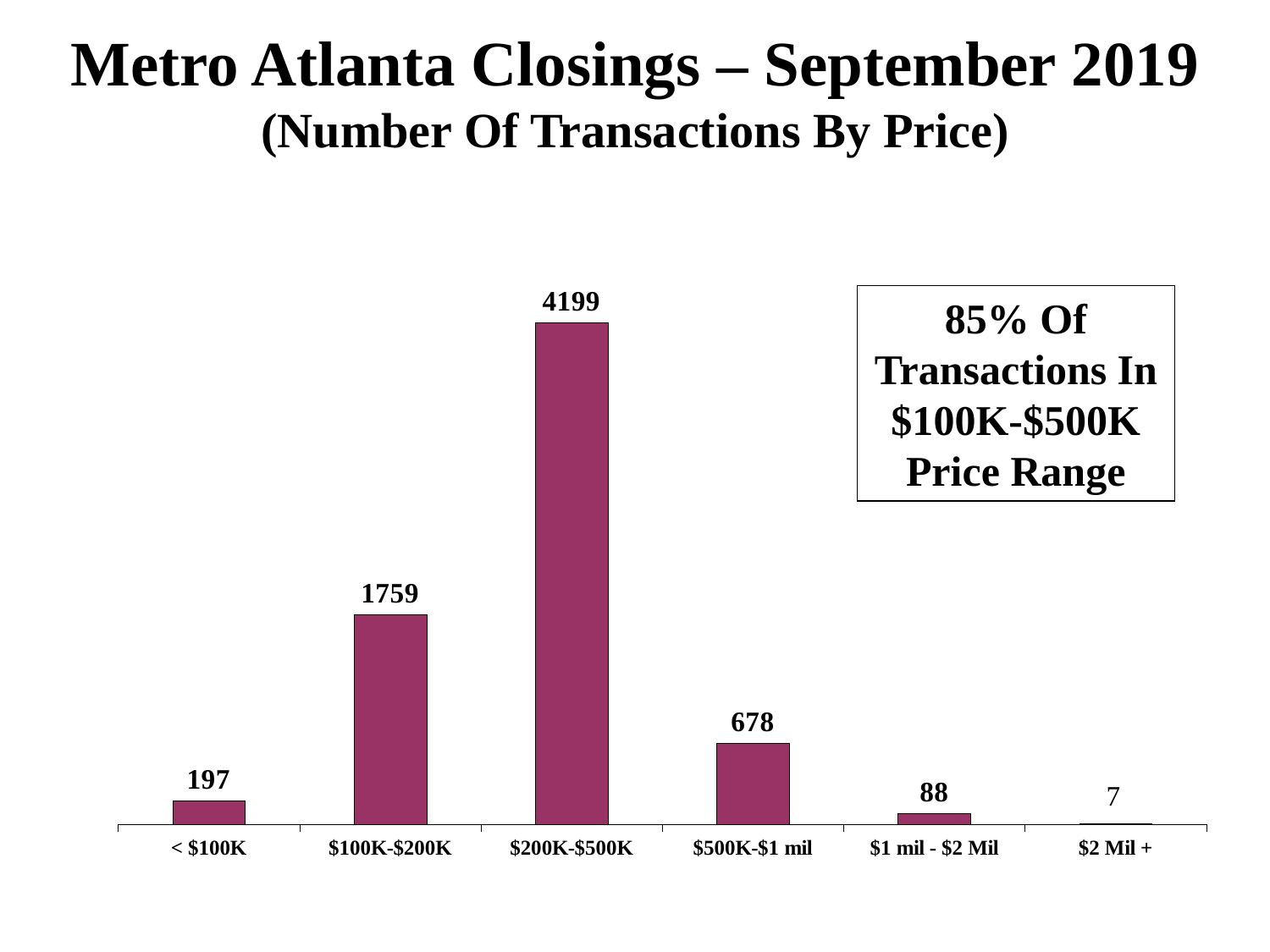
How many transactions were in the $200K-$500K price range? 4199 Which price range has the lowest number of transactions? $2 Mil + How many transactions were in the $2 Mil + category? 7 Which price range has the highest number of transactions? $200K-$500K Which has more transactions: < $100K or $500K-$1 mil? $500K-$1 mil According to the text box on the slide, what percentage of transactions were in the $100K-$500K price range? 85% What is the difference between the number of transactions in the $200K-$500K range and the $100K-$200K range? 2440 What is the number of transactions for the $100K-$200K category? 1759 How many price range categories are shown on the chart? 6 What is the title of the chart on the slide? Metro Atlanta Closings – September 2019 (Number Of Transactions By Price) What is the difference between the $500K-$1 mil and $1 mil - $2 Mil transaction counts? 590 What type of chart is shown on the slide? Bar chart